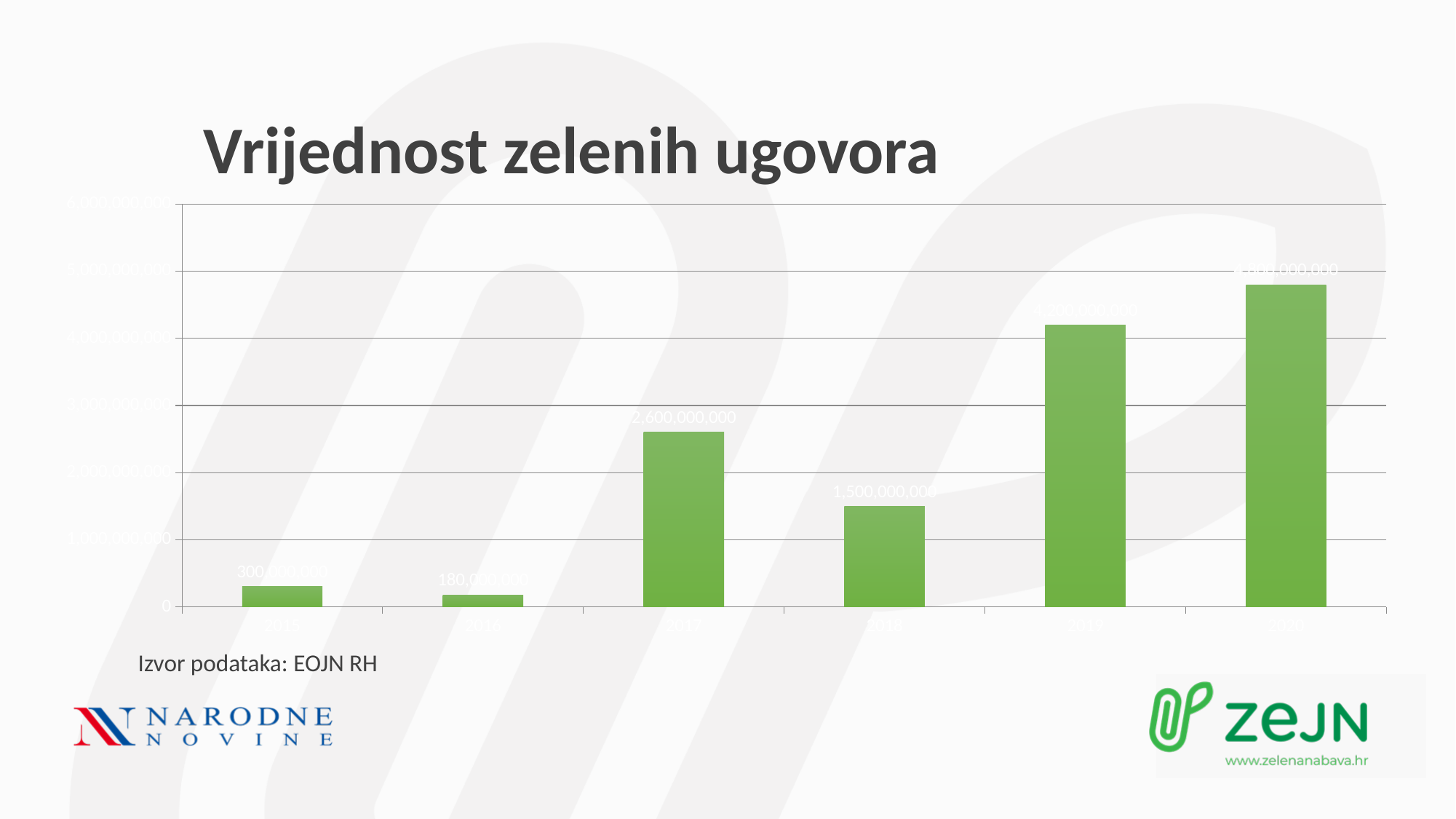
What is the difference between the values for 2017 and 2018? 1,100,000,000 What kind of chart is shown on the slide? bar chart What is the value for 2017? 2,600,000,000 Which is larger, the value for 2017 or the value for 2018? 2017 What is the value for 2019? 4,200,000,000 What is the value for 2015? 300,000,000 How many years are shown on the x axis? 6 Which year has the lowest value? 2016 Which year has the highest value? 2020 What is the value for 2018? 1,500,000,000 What is the difference between the values for 2015 and 2016? 120,000,000 Is the value for 2020 greater or less than 4,000,000,000? greater